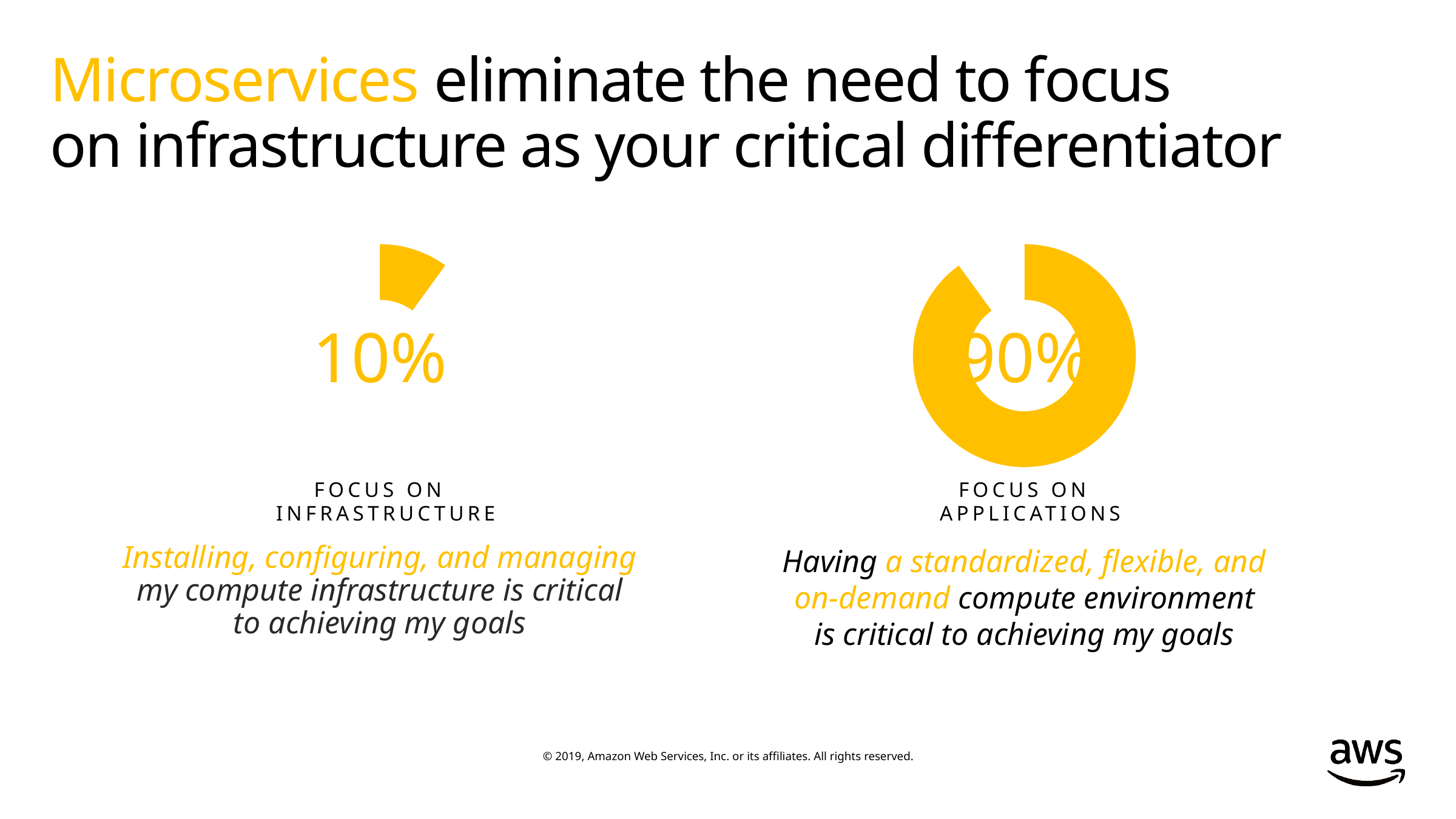
Which chart on the slide shows the smallest percentage? Focus on infrastructure What colour are the filled segments of the two charts? Yellow/orange Which of the two charts shows the larger percentage, "Focus on infrastructure" or "Focus on applications"? Focus on applications What is the difference between the percentage on the "Focus on applications" chart and the percentage on the "Focus on infrastructure" chart? 80 percentage points Is the value shown on the left "Focus on infrastructure" chart greater or less than 50%? less What percentage is shown on the left chart labelled "Focus on infrastructure"? 10% How many charts are shown on the slide? 2 What kind of chart is used on the right side of the slide for "Focus on applications"? Donut chart What percentage is shown on the right chart labelled "Focus on applications"? 90% What do the percentages on the two charts add up to? 100% What is the label printed beneath the left chart? FOCUS ON INFRASTRUCTURE Is the value shown on the right "Focus on applications" chart greater or less than 50%? greater